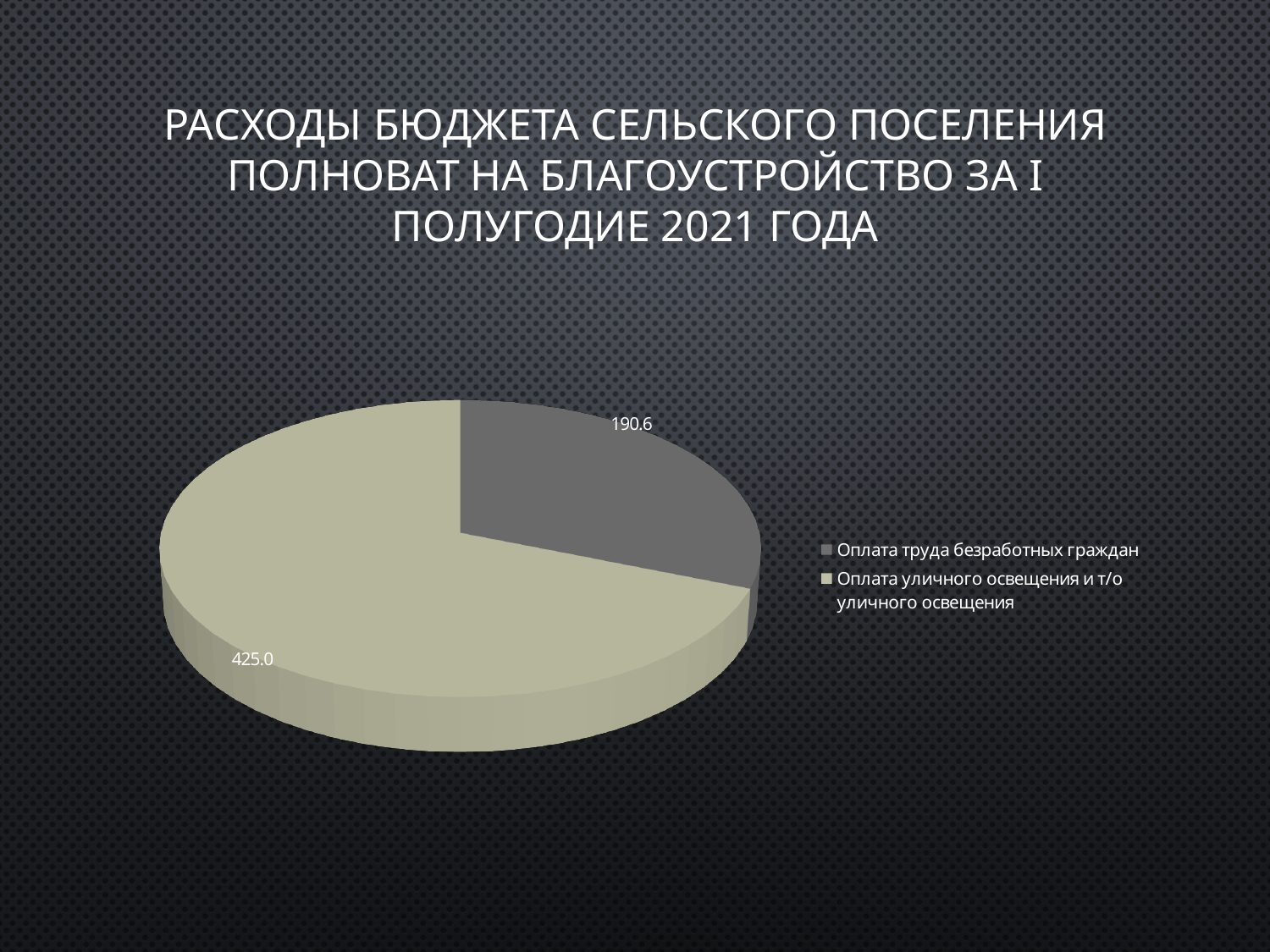
What is the title of the chart on the slide? Расходы бюджета сельского поселения Полноват на благоустройство за I полугодие 2021 года What type of chart is shown on the slide? Pie chart What is the difference between the value for "Оплата уличного освещения и т/о уличного освещения" and the value for "Оплата труда безработных граждан"? 234.4 Which category has the smallest slice of the pie? Оплата труда безработных граждан What is the total of all slices in the pie chart? 615.6 Which is larger: the value for "Оплата труда безработных граждан" or the value for "Оплата уличного освещения и т/о уличного освещения"? Оплата уличного освещения и т/о уличного освещения Which category has the largest slice of the pie? Оплата уличного освещения и т/о уличного освещения What share of the pie does "Оплата уличного освещения и т/о уличного освещения" represent? 69.0% What is the value for "Оплата уличного освещения и т/о уличного освещения"? 425.0 What is the value for "Оплата труда безработных граждан"? 190.6 How many categories does the pie chart show? 2 Which colour represents "Оплата труда безработных граждан" in the legend? Dark gray